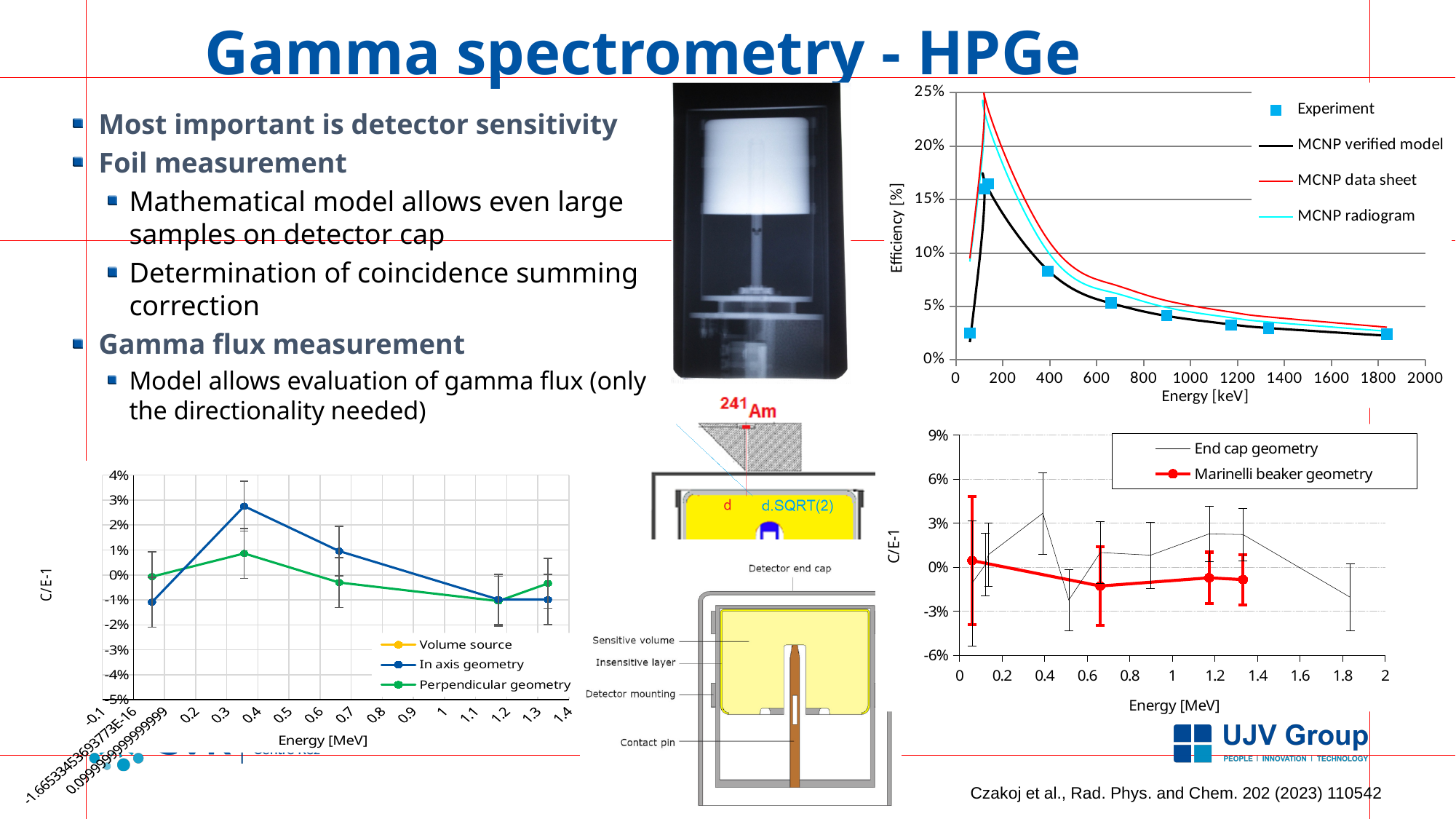
In the bottom-left C/E-1 chart, how many series does the legend list? 3 What kind of chart is the bottom-left C/E-1 chart? line chart In the bottom-left C/E-1 chart, is the In axis geometry value at about 0.35 MeV greater or less than 2%? greater In the bottom-left C/E-1 chart, at about 0.35 MeV, which series has the higher value: In axis geometry or Perpendicular geometry? In axis geometry In the top-right efficiency chart, how many series does the legend list? 4 In the bottom-right C/E-1 chart, is the End cap geometry value at about 1.85 MeV greater or less than 0%? less In the top-right efficiency chart, what is the label of the y axis? Efficiency [%] In the top-right efficiency chart, do the curves rise or fall with energy above about 200 keV? fall In the top-right efficiency chart, is the Experiment value at about 120 keV greater or less than 10%? greater In the bottom-right C/E-1 chart, how many series does the legend list? 2